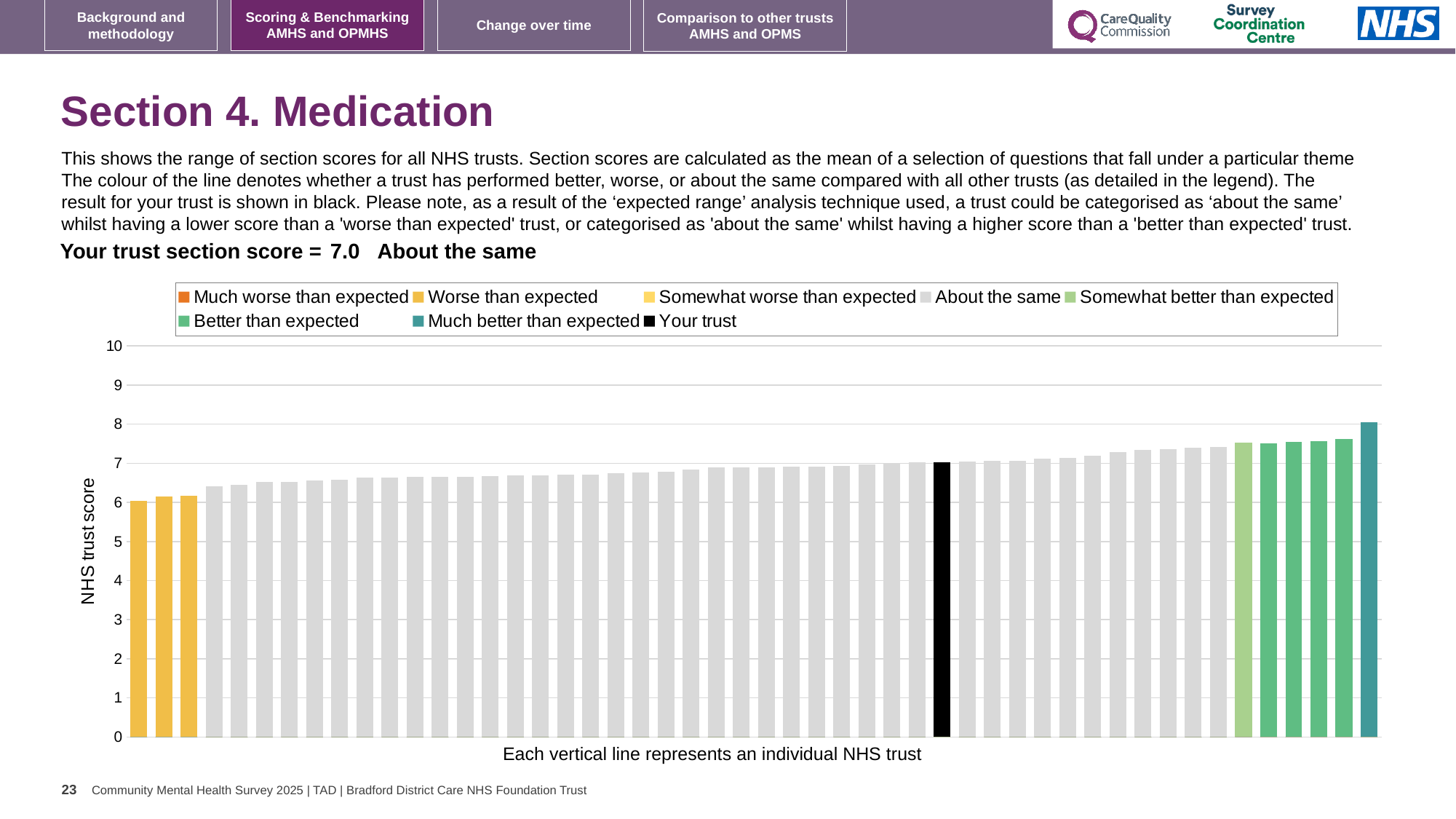
Which performance category is your trust placed in for Section 4. Medication? About the same What kind of chart is shown on the slide? bar chart How many bars are coloured as 'Somewhat better than expected'? 1 Do the bar values rise or fall from left to right along the x axis? rise How many bars are coloured as 'Much better than expected'? 1 How many entries does the chart legend list? 8 What is the section score for your trust? 7.0 Is the value for your trust greater or less than 5? greater Is the value of the highest bar greater or less than 9? less Is the value of the lowest bar greater or less than 5? greater What is the label on the vertical axis of the chart? NHS trust score How many bars are coloured as 'Worse than expected'? 3